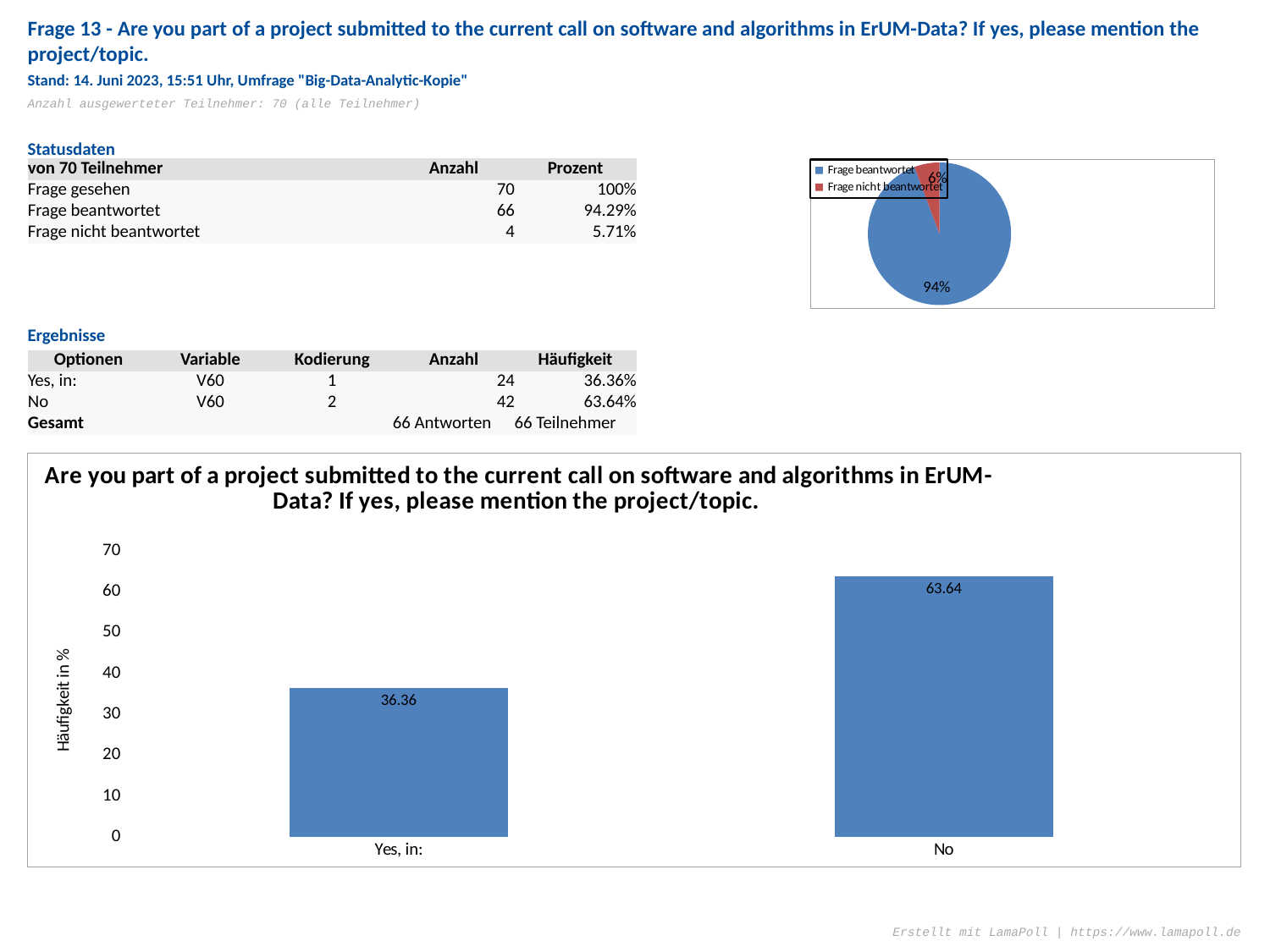
In the bar chart at the bottom of the slide, what is the value for "Yes, in:"? 36.36 In the bar chart at the bottom of the slide, is the value for "Yes, in:" greater or less than 40? less In the bar chart at the bottom of the slide, what is the label of the y axis? Häufigkeit in % In the bar chart at the bottom of the slide, what is the difference between the values for "No" and "Yes, in:"? 27.28 How many entries does the legend of the pie chart at the top right of the slide list? 2 In the bar chart at the bottom of the slide, how many categories are shown on the x axis? 2 In the pie chart at the top right of the slide, what share is shown for "Frage nicht beantwortet"? 6% In the bar chart at the bottom of the slide, what is the value for "No"? 63.64 In the bar chart at the bottom of the slide, which category has the lowest value? Yes, in: In the bar chart at the bottom of the slide, which category has the highest value? No In the pie chart at the top right of the slide, what share is shown for "Frage beantwortet"? 94% What kind of chart is shown at the bottom of the slide? bar chart